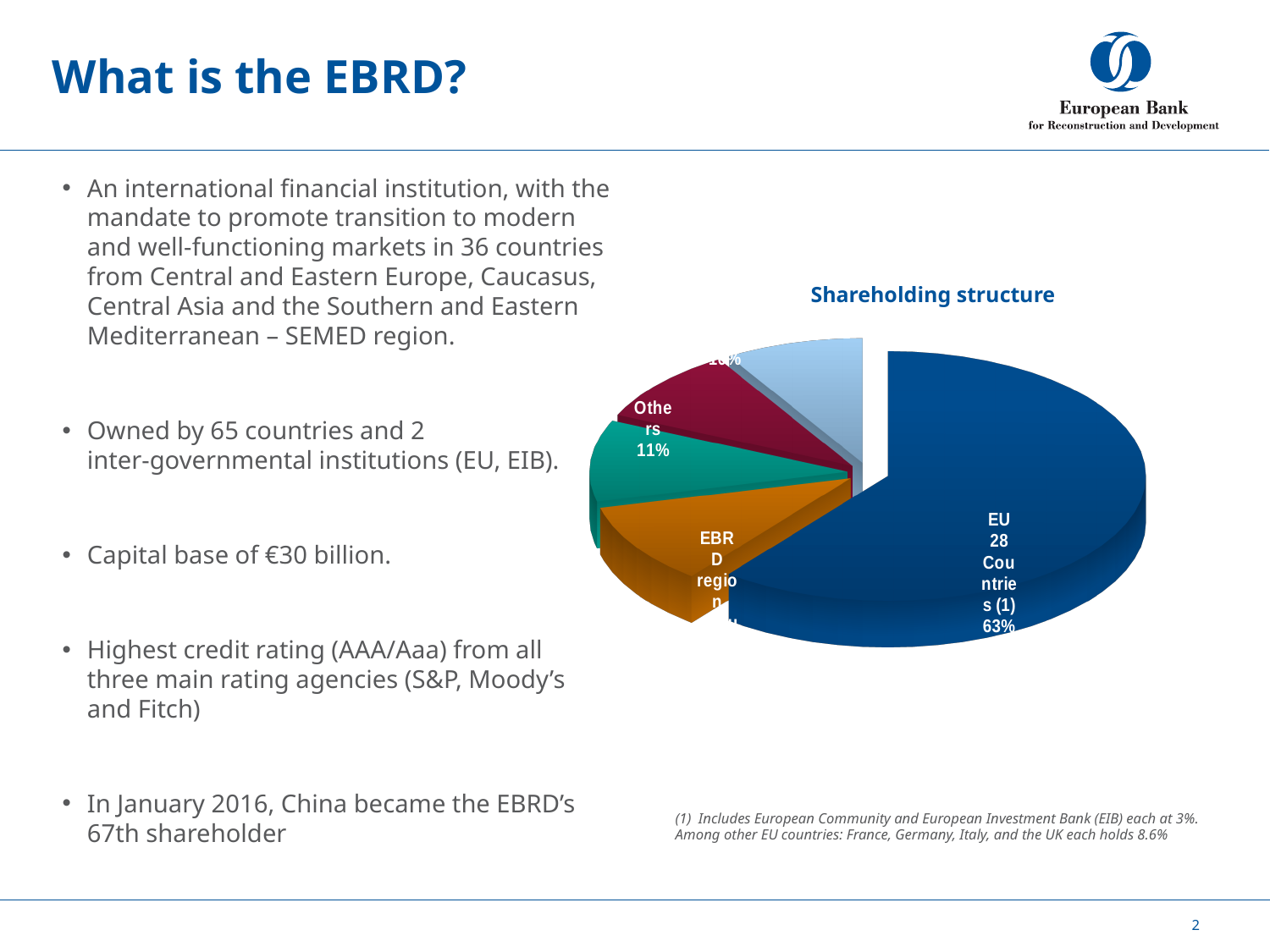
What share of the shareholding structure is held by the EU 28 Countries (1)? 63% Which is larger: the share of EU 28 Countries (1) or the share of Others? EU 28 Countries (1) Which slice of the pie chart is the largest? EU 28 Countries (1) How many slices does the pie chart have? 5 What share of the shareholding structure is held by Others? 11% What kind of chart is shown on the slide? pie chart What is the title of the chart? Shareholding structure By how many percentage points does the EU 28 Countries (1) share exceed the Others share? 52 percentage points According to the footnote under the chart, what share does the European Investment Bank (EIB) hold? 3%